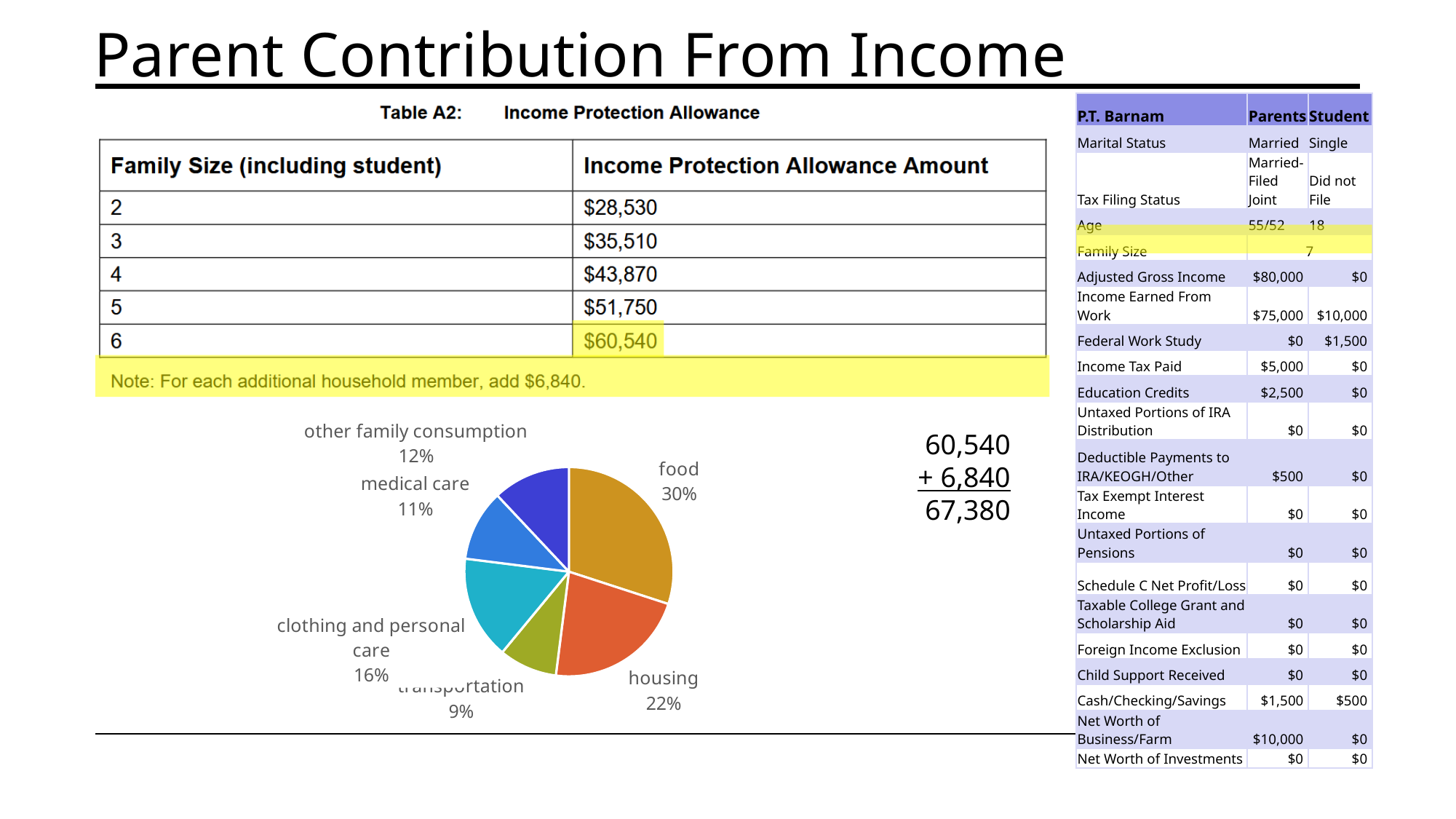
What share of the pie chart does housing account for? 22% What is the difference in percentage points between food and housing in the pie chart? 8 What kind of chart is shown on the slide? pie chart What share of the pie chart does food account for? 30% What percentage is shown for clothing and personal care in the pie chart? 16% Which is larger in the pie chart, medical care or other family consumption? other family consumption Which category has the largest slice in the pie chart? food What percentage is shown for transportation in the pie chart? 9% How many slices does the pie chart have? 6 Which category has the smallest slice in the pie chart? transportation What colour is the food slice in the pie chart? orange-gold What percentage is shown for medical care in the pie chart? 11%